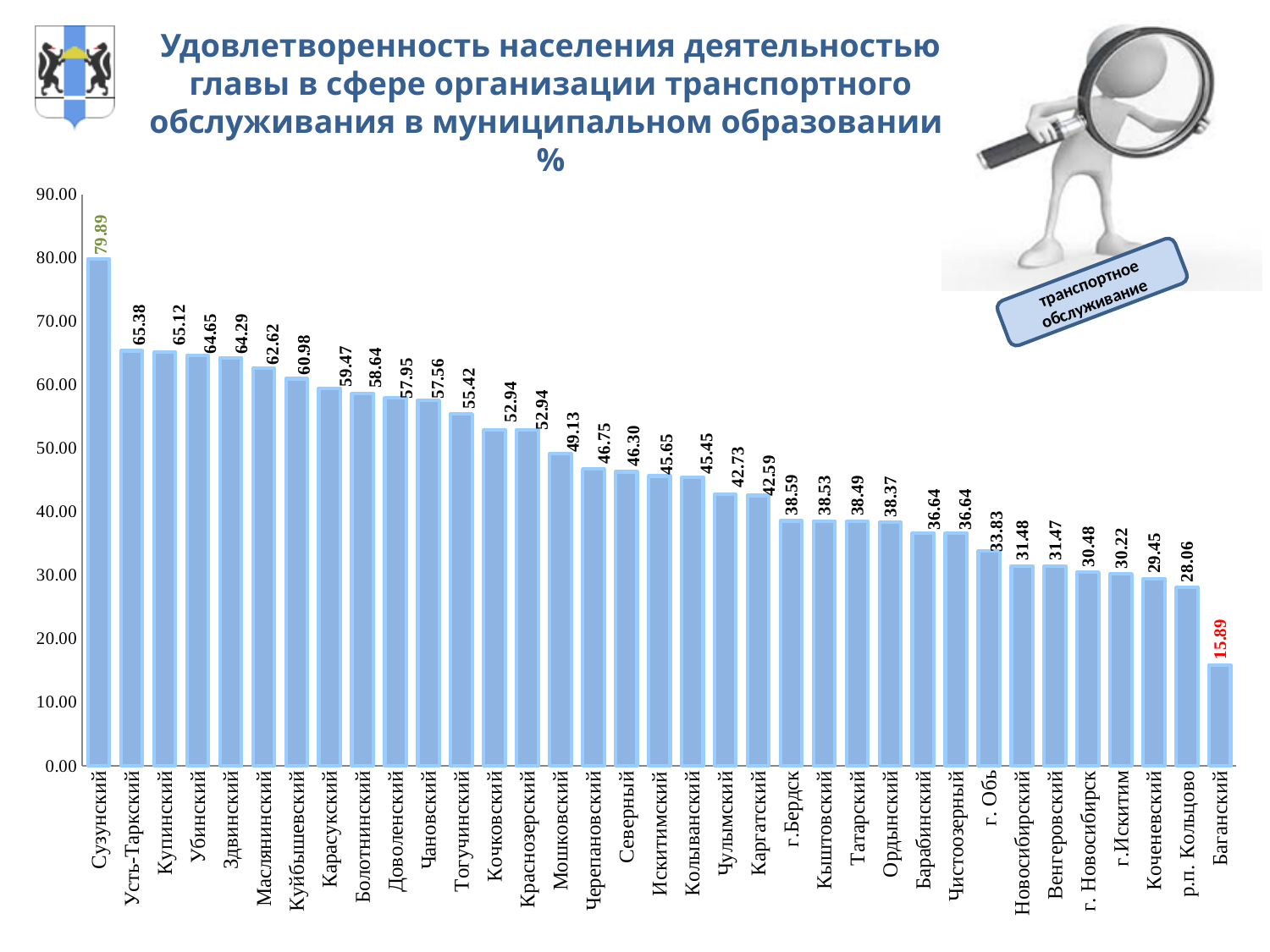
What is the difference between the values for Сузунский and Баганский? 64.00 What kind of chart is shown on the slide? bar chart Which is larger, the value for Усть-Таркский or the value for Маслянинский? Усть-Таркский Do the values rise or fall from left to right along the x axis? fall What is the value for Сузунский? 79.89 What is the value for Мошковский? 49.13 Which category has the lowest value? Баганский What is the value for Баганский? 15.89 Is the value for Чулымский greater or less than 40.00? greater How many categories are shown on the chart? 35 Which category has the highest value? Сузунский What is the value for г. Новосибирск? 30.48